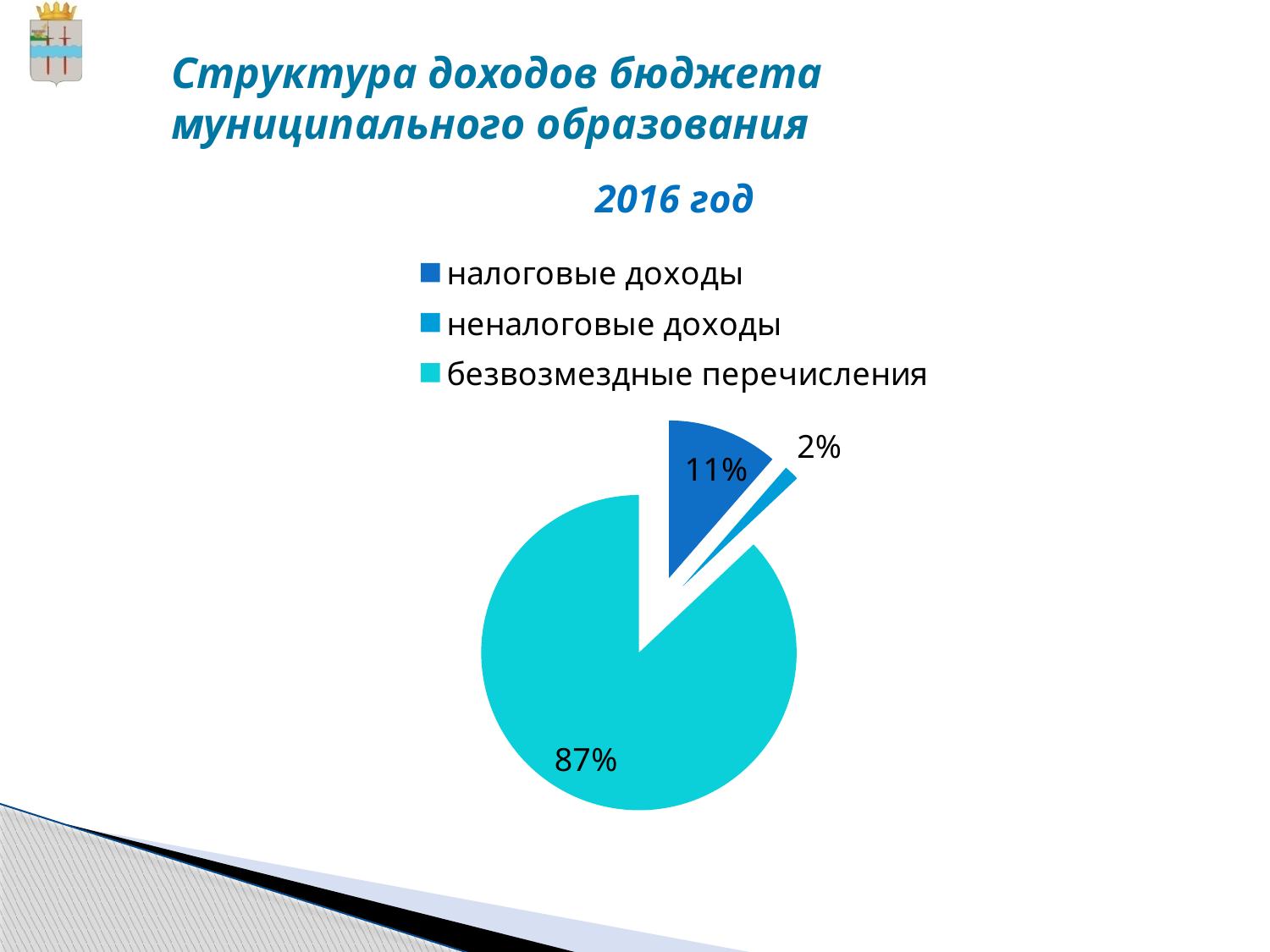
What is the difference in percentage points between безвозмездные перечисления and налоговые доходы? 76 What share of the pie does налоговые доходы have? 11% What share of the pie does неналоговые доходы have? 2% How many slices does the pie chart have? 3 What share of the pie does безвозмездные перечисления have? 87% Which category has the smallest slice of the pie? неналоговые доходы What is the difference in percentage points between налоговые доходы and неналоговые доходы? 9 How many entries does the legend list? 3 Which category has the largest slice of the pie? безвозмездные перечисления Which is larger, налоговые доходы or неналоговые доходы? налоговые доходы What kind of chart is shown on the slide? pie chart What year is shown in the chart title? 2016 год